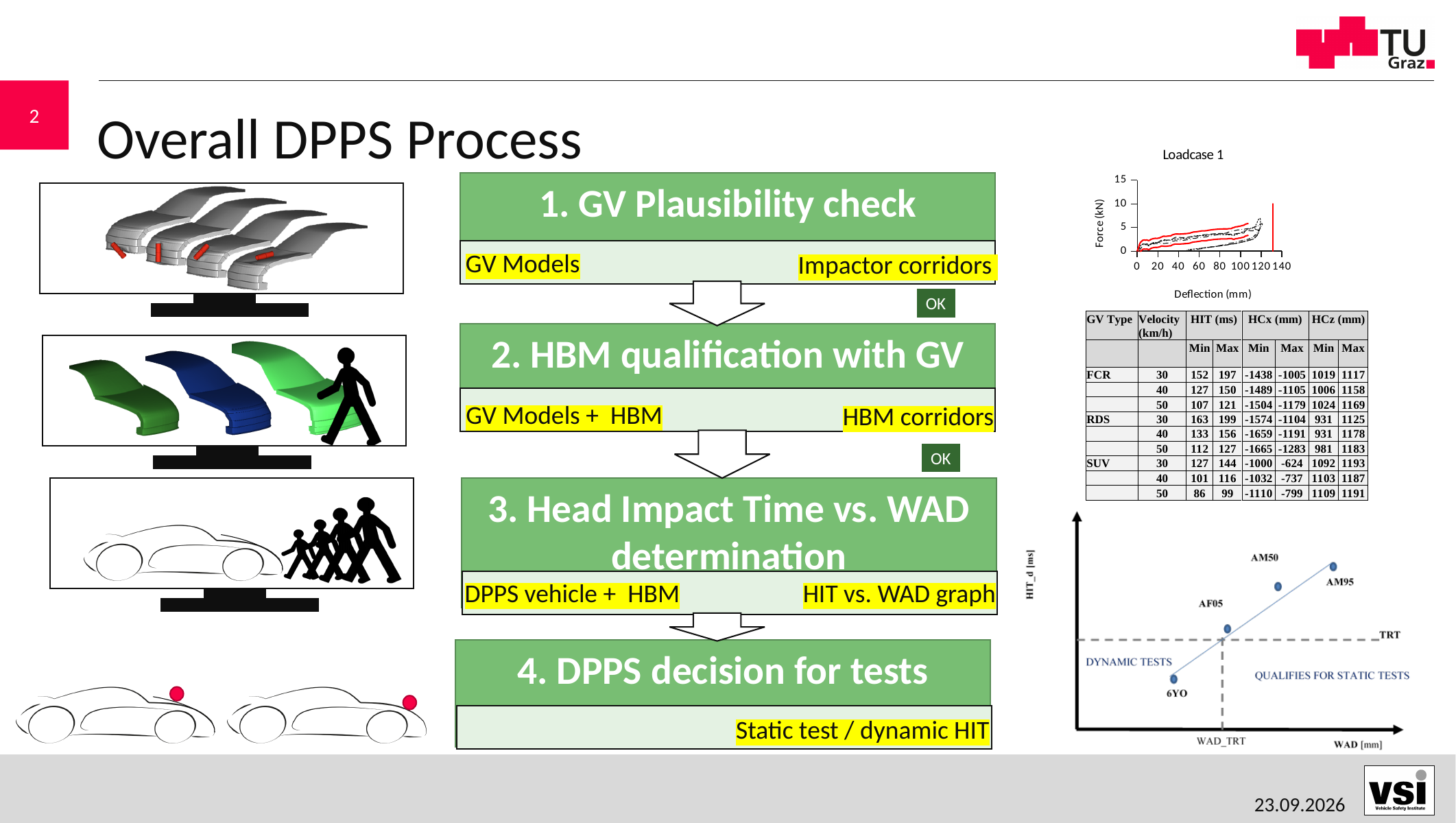
In the HIT vs. WAD diagram at the bottom right, how many labelled data points are plotted? 4 In the Loadcase 1 chart, what kind of chart is shown? line chart In the HIT vs. WAD diagram at the bottom right, which labelled point has the lowest HIT_d value? 6YO In the HIT vs. WAD diagram at the bottom right, what is the label of the horizontal dashed line? TRT In the Loadcase 1 chart, is the force at a deflection of 100 mm greater or less than 10? less In the Loadcase 1 chart, what is the label of the y axis? Force (kN) In the HIT vs. WAD diagram at the bottom right, which labelled point has the highest HIT_d value? AM95 What is the title of the chart in the upper right of the slide? Loadcase 1 In the HIT vs. WAD diagram at the bottom right, which point has a higher HIT_d value, AF05 or AM50? AM50 In the Loadcase 1 chart, what is the highest tick value shown on the x axis (Deflection)? 140 In the HIT vs. WAD diagram at the bottom right, do the HIT_d values rise or fall as WAD increases? rise In the Loadcase 1 chart, is the force at a deflection of 20 mm greater or less than 5? less